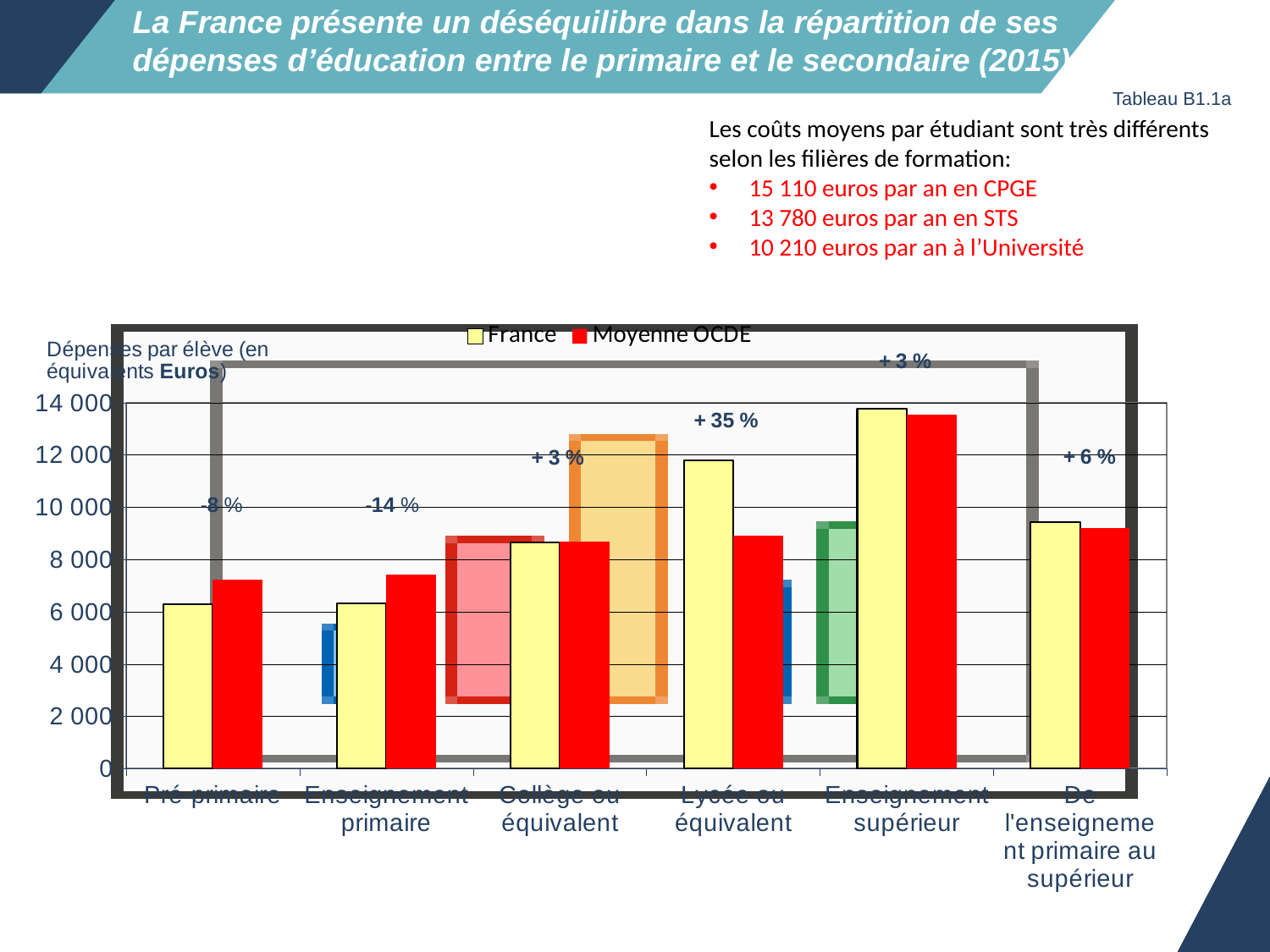
Is the France value for Enseignement supérieur greater or less than 12 000? greater What percentage annotation is shown above the Lycée ou équivalent bars? + 35 % How many series does the legend list? 2 What kind of chart is shown on the slide? bar chart For Lycée ou équivalent, which is larger: the France value or the Moyenne OCDE value? France Which category has the highest value for the France series? Enseignement supérieur How many categories are shown on the x axis of the chart? 6 Is the France value for Lycée ou équivalent greater or less than 10 000? greater Which category has the highest value for the Moyenne OCDE series? Enseignement supérieur For Pré-primaire, which is larger: the France value or the Moyenne OCDE value? Moyenne OCDE What are the two series named in the chart legend? France and Moyenne OCDE Is the Moyenne OCDE value for Enseignement primaire greater or less than 8 000? less